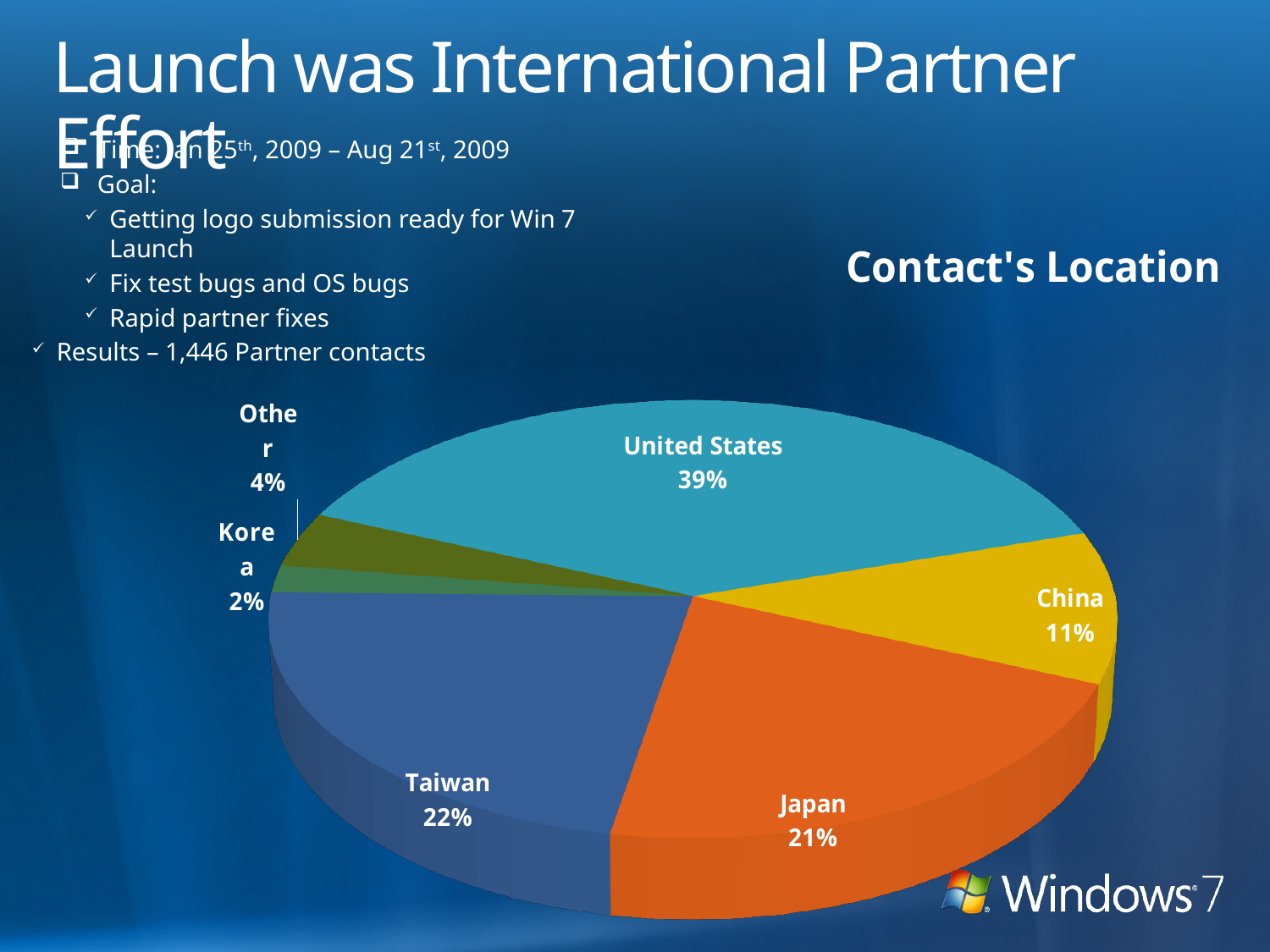
What share of contacts is from the United States? 39% What share of contacts is from China? 11% What is the difference in share between the United States and Taiwan? 17% What share of contacts is from Korea? 2% Which location has the smallest share of contacts? Korea What kind of chart is shown on the slide? Pie chart What is the title of the chart? Contact's Location Which location has the largest share of contacts? United States What is the combined share of Taiwan and Japan? 43% How many locations are shown in the pie chart? 6 Which has a larger share of contacts, China or Japan? Japan What share of contacts is from Japan? 21%